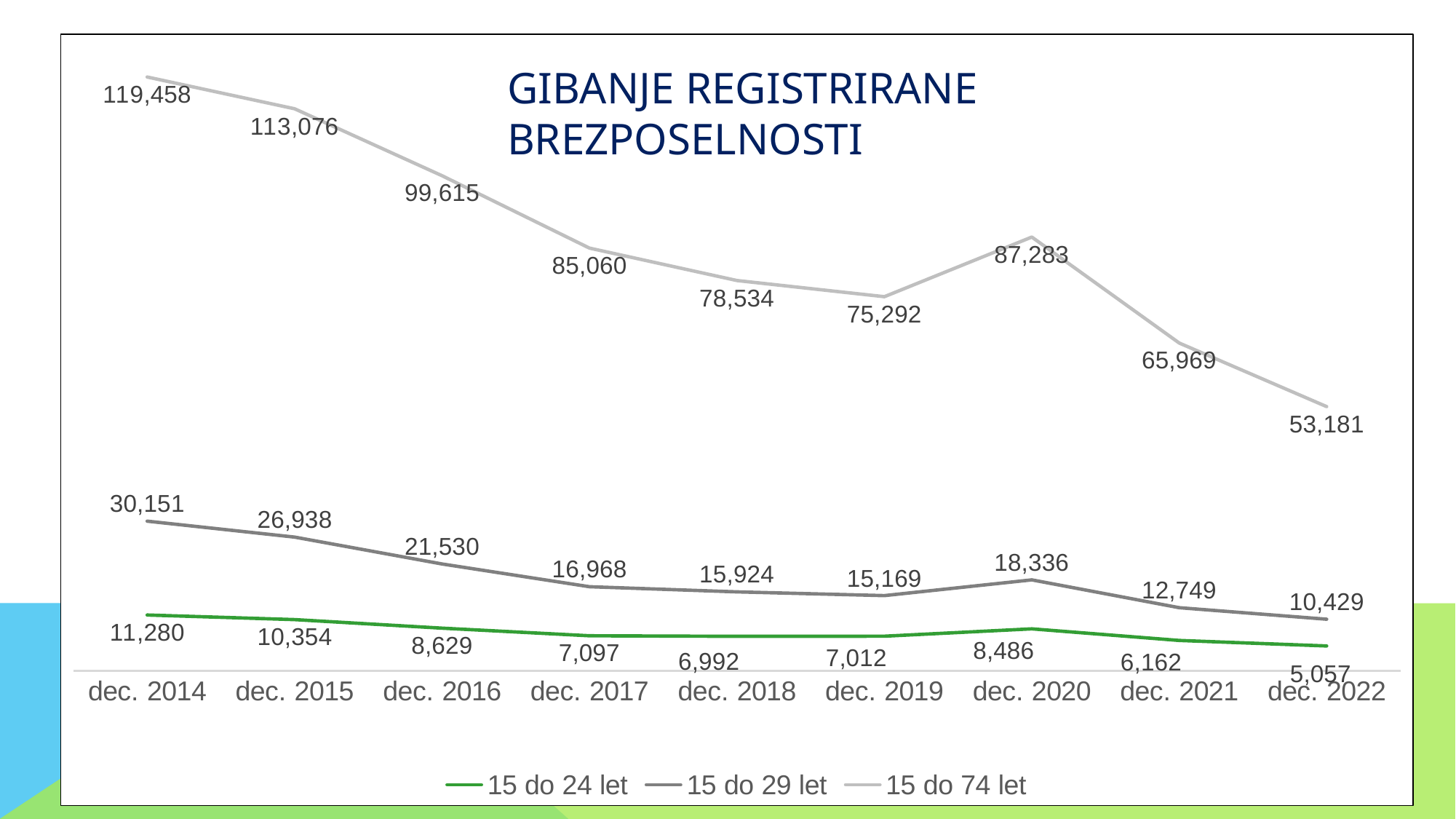
How many series does the legend list? 3 What kind of chart is shown on the slide? Line chart How many time periods are shown on the x axis? 9 What is the title of the chart? GIBANJE REGISTRIRANE BREZPOSELNOSTI What is the difference between the '15 do 74 let' values in dec. 2019 and dec. 2020? 11,991 Does the '15 do 74 let' series generally rise or fall from dec. 2014 to dec. 2022? Fall What is the value for the '15 do 29 let' series in dec. 2020? 18,336 In which period is the '15 do 24 let' series at its highest? dec. 2014 Which is larger: the '15 do 29 let' value in dec. 2021 or in dec. 2022? dec. 2021 What is the value for the '15 do 74 let' series in dec. 2014? 119,458 In which period is the '15 do 74 let' series at its lowest? dec. 2022 What is the value for the '15 do 24 let' series in dec. 2022? 5,057